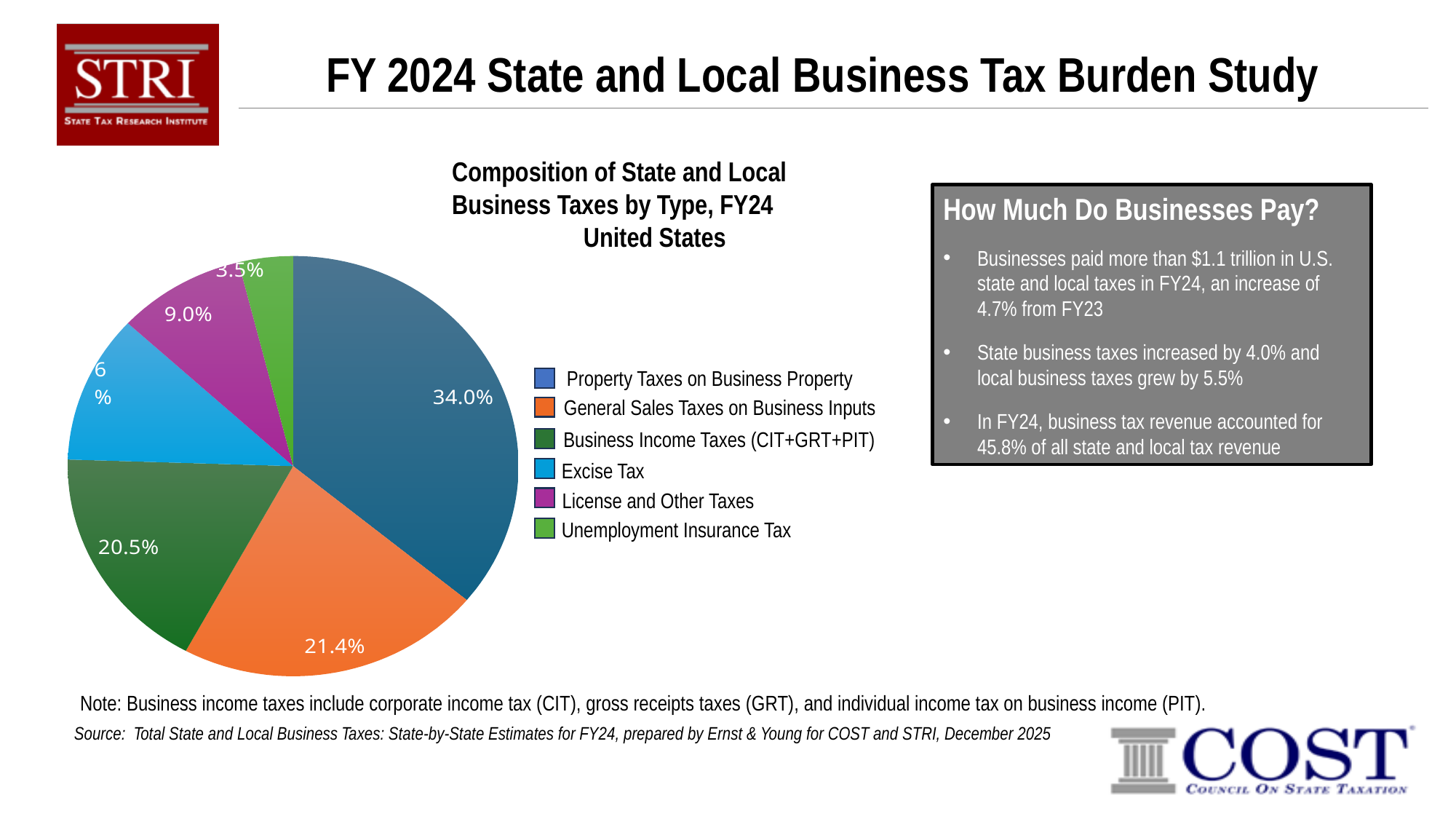
What share of the pie chart is Unemployment Insurance Tax? 3.5% How many tax types are shown in the pie chart? 6 What share of state and local business taxes do Property Taxes on Business Property account for in the pie chart? 34.0% How many percentage points larger is the Property Taxes on Business Property share than the General Sales Taxes on Business Inputs share? 12.6 percentage points What percentage of the pie chart is General Sales Taxes on Business Inputs? 21.4% Which tax type has the smallest slice in the pie chart? Unemployment Insurance Tax What percentage of the pie chart is License and Other Taxes? 9.0% What is the title of the chart on the slide? Composition of State and Local Business Taxes by Type, FY24 United States What type of chart is shown on the slide? Pie chart Which is larger in the pie chart: General Sales Taxes on Business Inputs or Business Income Taxes (CIT+GRT+PIT)? General Sales Taxes on Business Inputs What share does Business Income Taxes (CIT+GRT+PIT) represent in the pie chart? 20.5% Which tax type has the largest slice in the pie chart? Property Taxes on Business Property